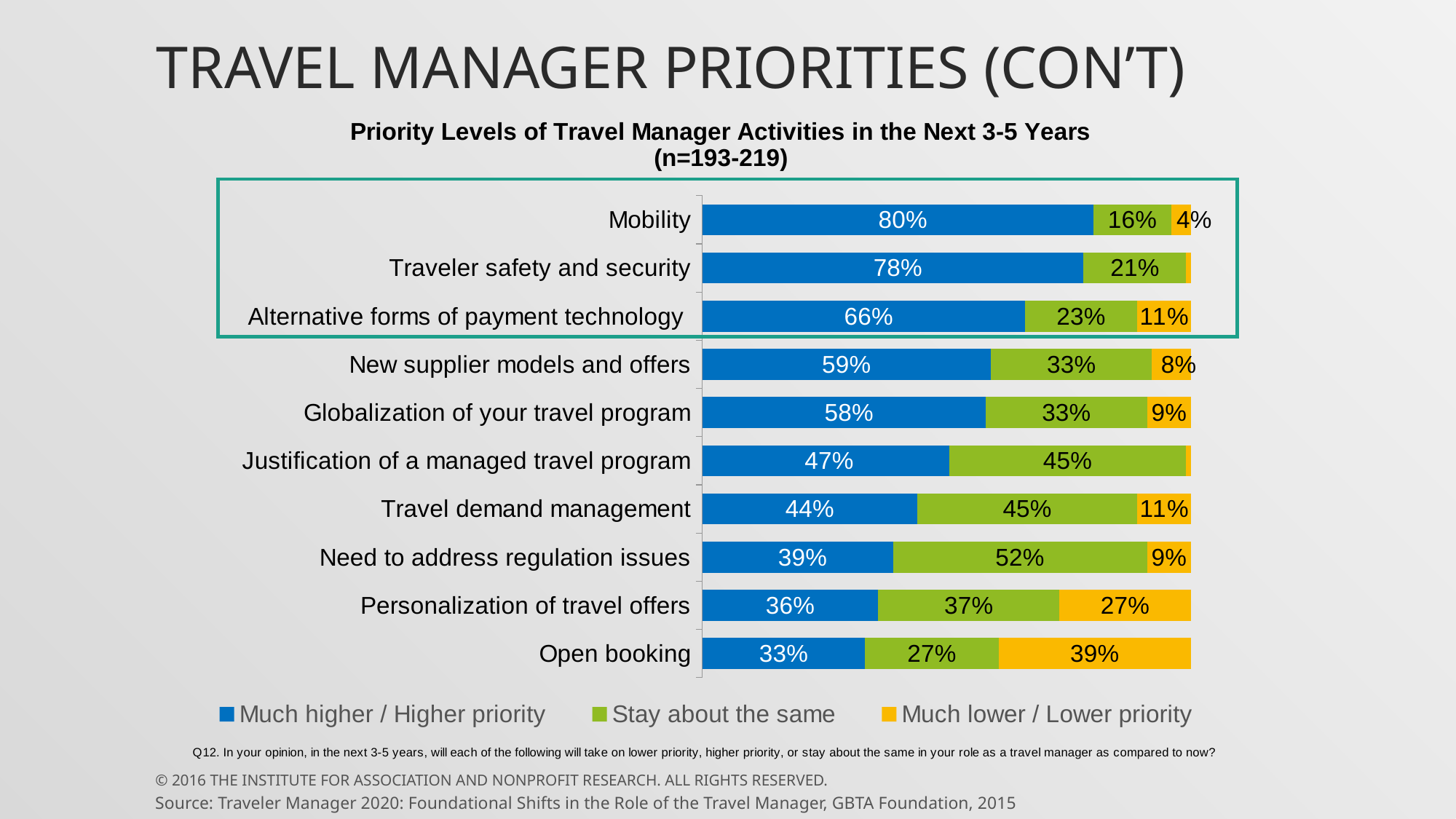
What is the 'Stay about the same' value for Need to address regulation issues? 52% What is the total of the three labeled segments for Mobility? 100% What percentage of respondents said Mobility will be a much higher / higher priority? 80% How many series does the legend list? 3 Which has a larger 'Much lower / Lower priority' value: Personalization of travel offers or Open booking? Open booking Which activity has the highest 'Much higher / Higher priority' percentage? Mobility What is the 'Much lower / Lower priority' value for Open booking? 39% What kind of chart is shown on the slide? Stacked bar chart How many activities are listed in the chart? 10 What colour represents 'Stay about the same' in the chart? Green Which activity has the lowest 'Much higher / Higher priority' percentage? Open booking What is the difference between the 'Much higher / Higher priority' values for Mobility and Alternative forms of payment technology? 14%